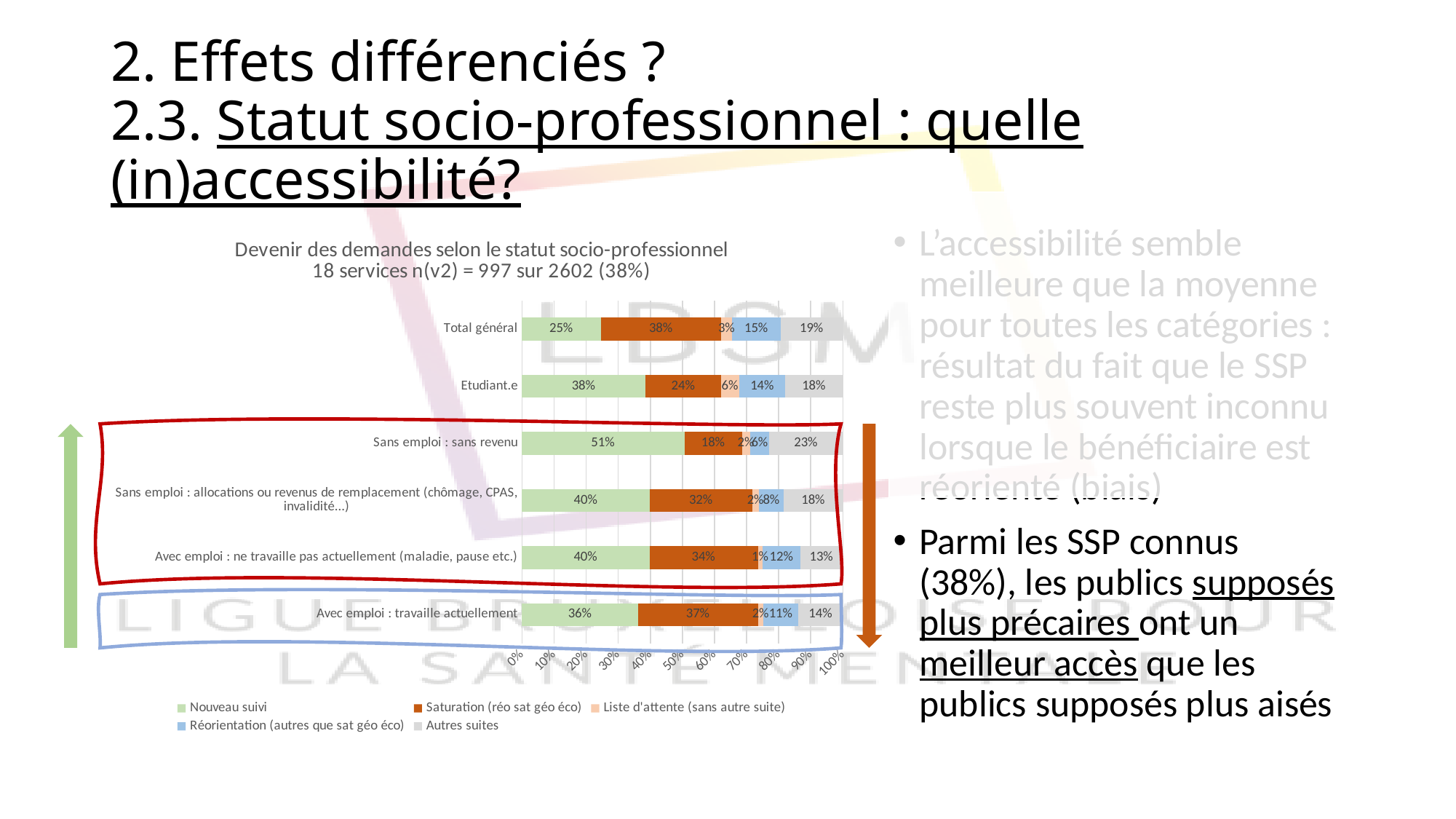
What is the 'Réorientation (autres que sat géo éco)' value for 'Avec emploi : ne travaille pas actuellement (maladie, pause etc.)'? 12% What is the 'Nouveau suivi' value for 'Sans emploi : sans revenu'? 51% What is the 'Autres suites' value for 'Etudiant.e'? 18% Which category has the highest 'Nouveau suivi' value? Sans emploi : sans revenu Which category has the lowest 'Nouveau suivi' value? Total général Which is larger: the 'Saturation (réo sat géo éco)' value for 'Etudiant.e' or for 'Avec emploi : travaille actuellement'? Avec emploi : travaille actuellement How many categories are plotted on the y axis of the chart? 6 How many series does the chart legend list? 5 What is the first line of the chart title? Devenir des demandes selon le statut socio-professionnel What is the difference between the 'Nouveau suivi' value for 'Sans emploi : sans revenu' and for 'Avec emploi : travaille actuellement'? 15% What is the 'Saturation (réo sat géo éco)' value for 'Total général'? 38% What kind of chart is shown on the slide? Stacked bar chart